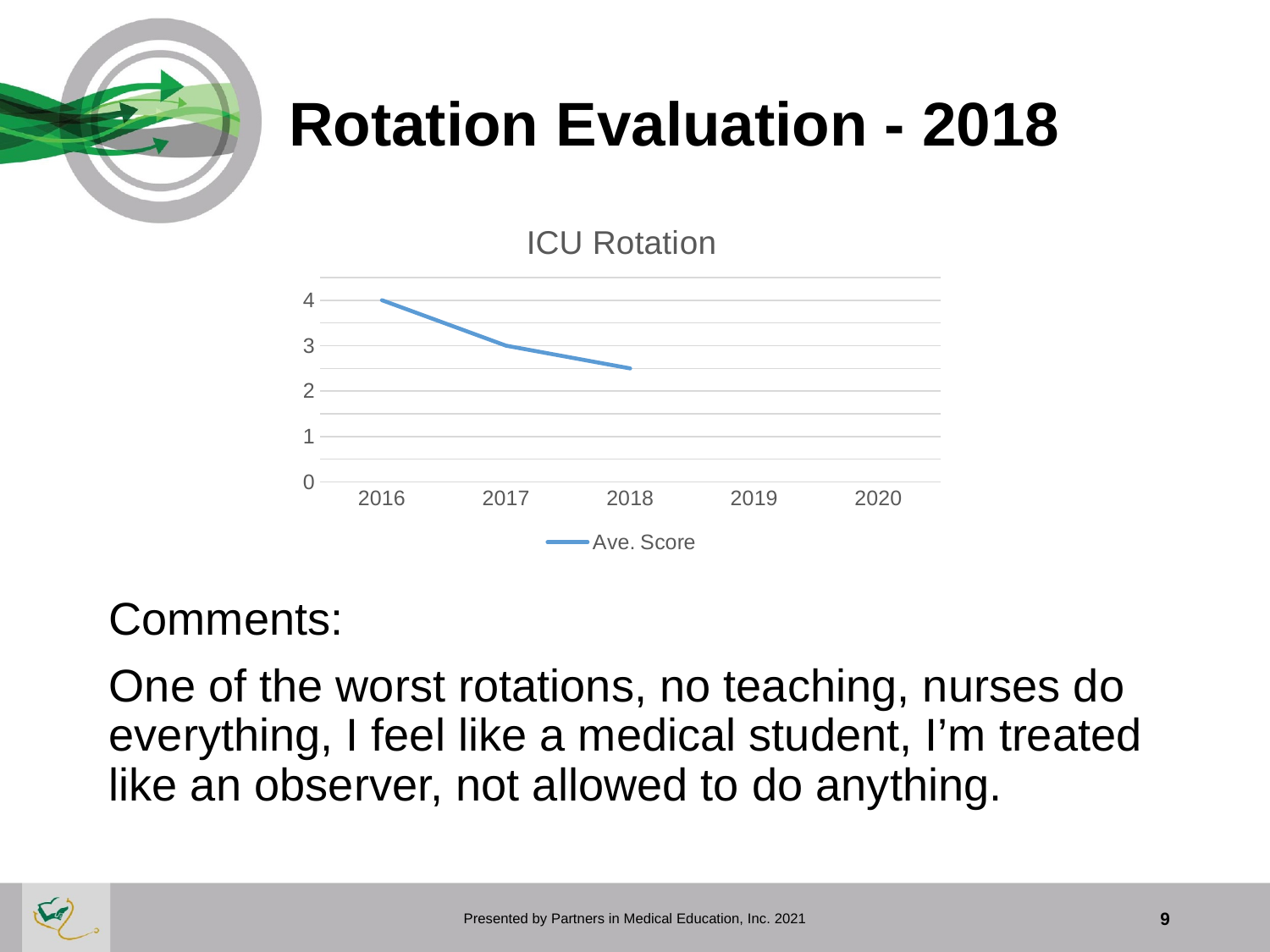
Is the Ave. Score for 2018 greater or less than 2? greater What is the Ave. Score for 2016? 4 What is the difference between the Ave. Score in 2016 and in 2017? 1 What series name does the legend show? Ave. Score What is the Ave. Score for 2017? 3 Does the Ave. Score rise or fall from 2016 to 2018? Fall Is the Ave. Score for 2018 greater or less than 3? less Which year has the highest Ave. Score? 2016 How many series does the legend list? 1 What is the title of the chart? ICU Rotation Which year with a plotted value has the lowest Ave. Score? 2018 What kind of chart is shown on the slide? Line chart